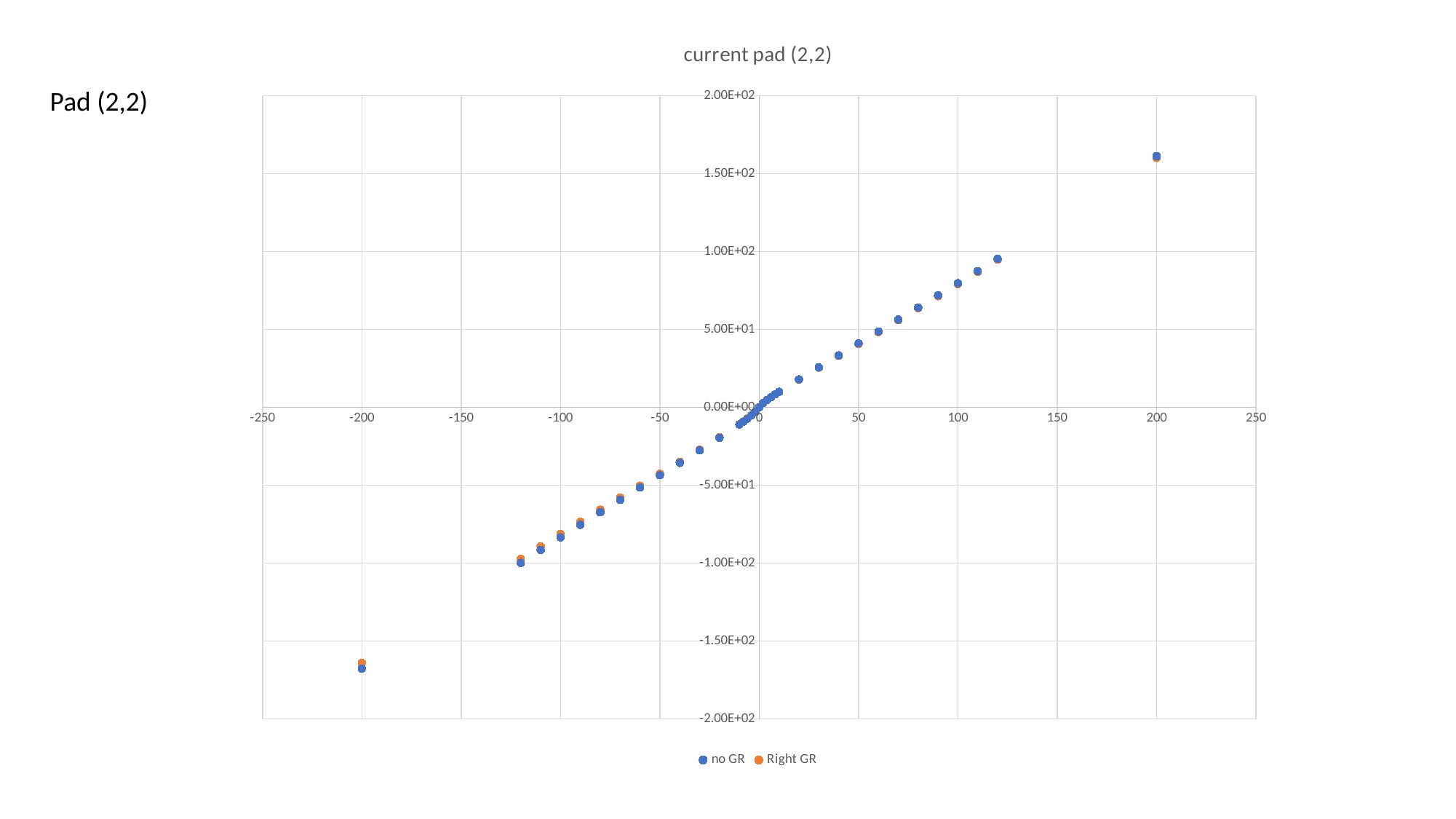
Is the value of the no GR series at x = 100 greater or less than 5.00E+01? greater Is the value of the no GR series at x = -100 greater or less than -5.00E+01? less Is the value of the no GR series at x = -200 greater or less than -1.00E+02? less What is the highest value shown on the y axis? 2.00E+02 Which series is plotted in orange? Right GR What is the title of the chart? current pad (2,2) What kind of chart is shown on the slide? scatter chart Do the plotted values rise or fall as the x axis increases? rise Which is larger, the no GR value at x = 200 or the no GR value at x = 100? the value at x = 200 How many series does the legend list? 2